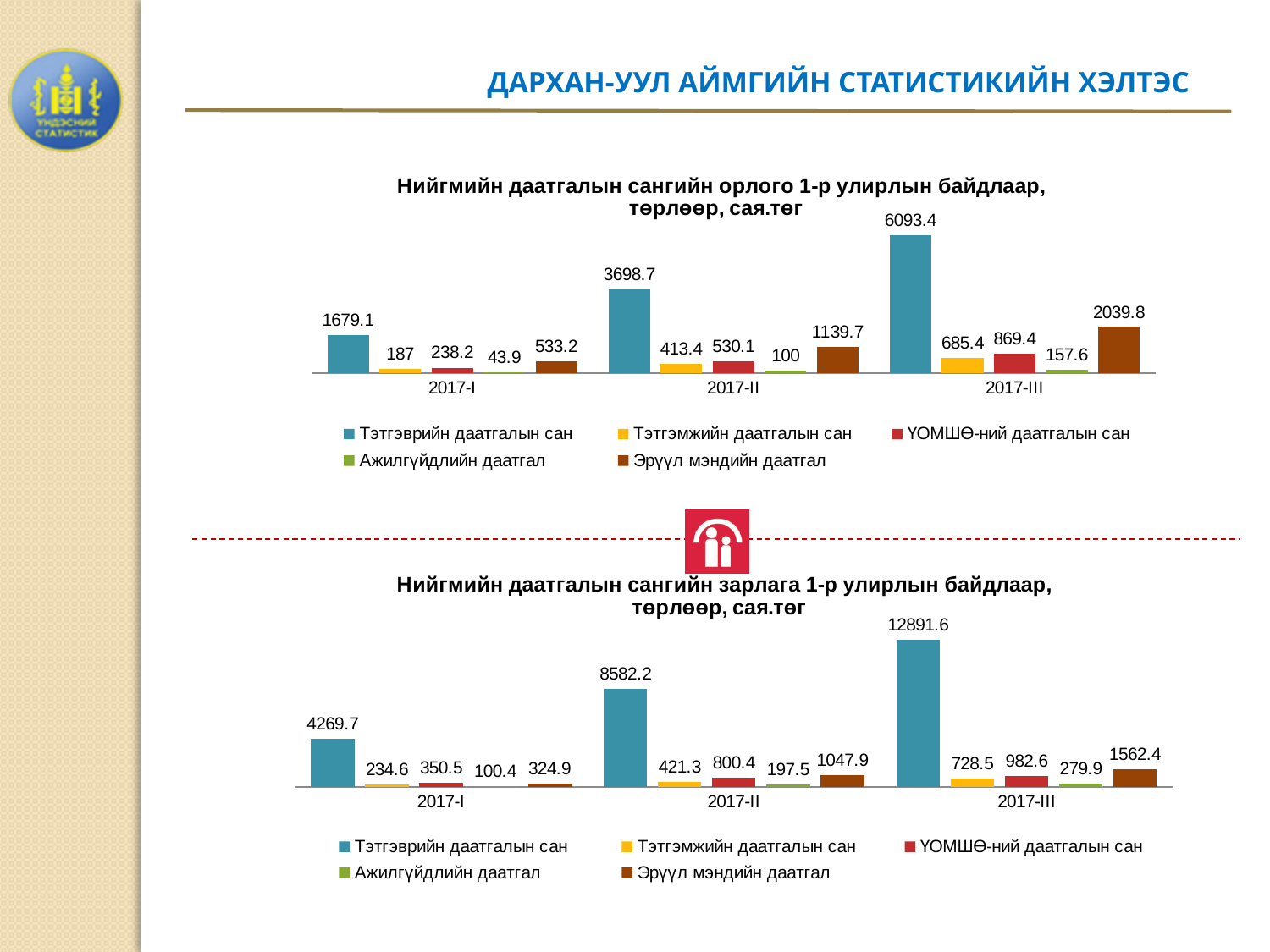
In the top chart (Нийгмийн даатгалын сангийн орлого), what is the value of Тэтгэврийн даатгалын сан for 2017-III? 6093.4 How many series does the legend of the bottom chart (Нийгмийн даатгалын сангийн зарлага) list? 5 In the bottom chart (Нийгмийн даатгалын сангийн зарлага), what is the value of ҮОМШӨ-ний даатгалын сан for 2017-III? 982.6 In the bottom chart (Нийгмийн даатгалын сангийн зарлага), what is the value of Тэтгэврийн даатгалын сан for 2017-I? 4269.7 In the bottom chart (Нийгмийн даатгалын сангийн зарлага), which period has the highest value for Тэтгэврийн даатгалын сан? 2017-III In the top chart (Нийгмийн даатгалын сангийн орлого), what is the value of Эрүүл мэндийн даатгал for 2017-II? 1139.7 How many periods are shown on the x axis of the top chart (Нийгмийн даатгалын сангийн орлого)? 3 In the top chart (Нийгмийн даатгалын сангийн орлого), what is the difference between the Тэтгэврийн даатгалын сан values for 2017-III and 2017-II? 2394.7 In the bottom chart (Нийгмийн даатгалын сангийн зарлага), what is the difference between the Эрүүл мэндийн даатгал values for 2017-III and 2017-I? 1237.5 In the top chart (Нийгмийн даатгалын сангийн орлого), which series has the lowest value for 2017-I? Ажилгүйдлийн даатгал In the top chart (Нийгмийн даатгалын сангийн орлого), which is larger for 2017-II: Тэтгэмжийн даатгалын сан or ҮОМШӨ-ний даатгалын сан? ҮОМШӨ-ний даатгалын сан In the bottom chart (Нийгмийн даатгалын сангийн зарлага), does the value of Тэтгэврийн даатгалын сан rise or fall from 2017-I to 2017-III? rise